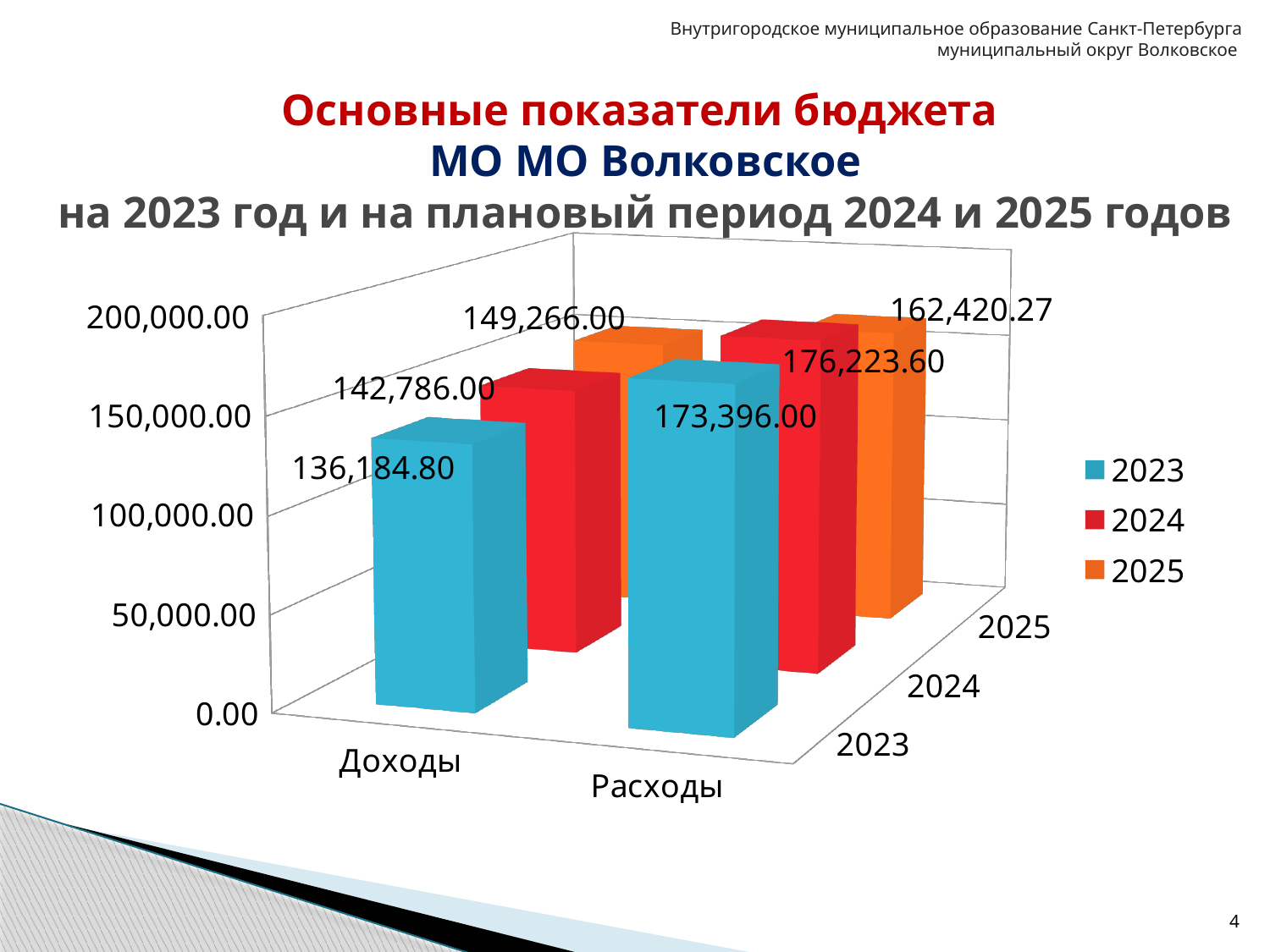
Which year has the highest value for Расходы? 2024 Which year has the lowest value for Доходы? 2023 Is the value for Расходы in 2023 greater or less than 150,000.00? greater What is the value for Расходы in 2025? 162,420.27 What kind of chart is shown on the slide? bar chart What is the value for Доходы in 2025? 149,266.00 What is the value for Расходы in 2024? 176,223.60 What is the difference between Расходы and Доходы in 2023? 37,211.20 How many series does the legend list? 3 By how much do Доходы in 2024 exceed Доходы in 2023? 6,601.20 What is the value for Доходы in 2023? 136,184.80 Which is larger: Расходы in 2025 or Доходы in 2025? Расходы in 2025